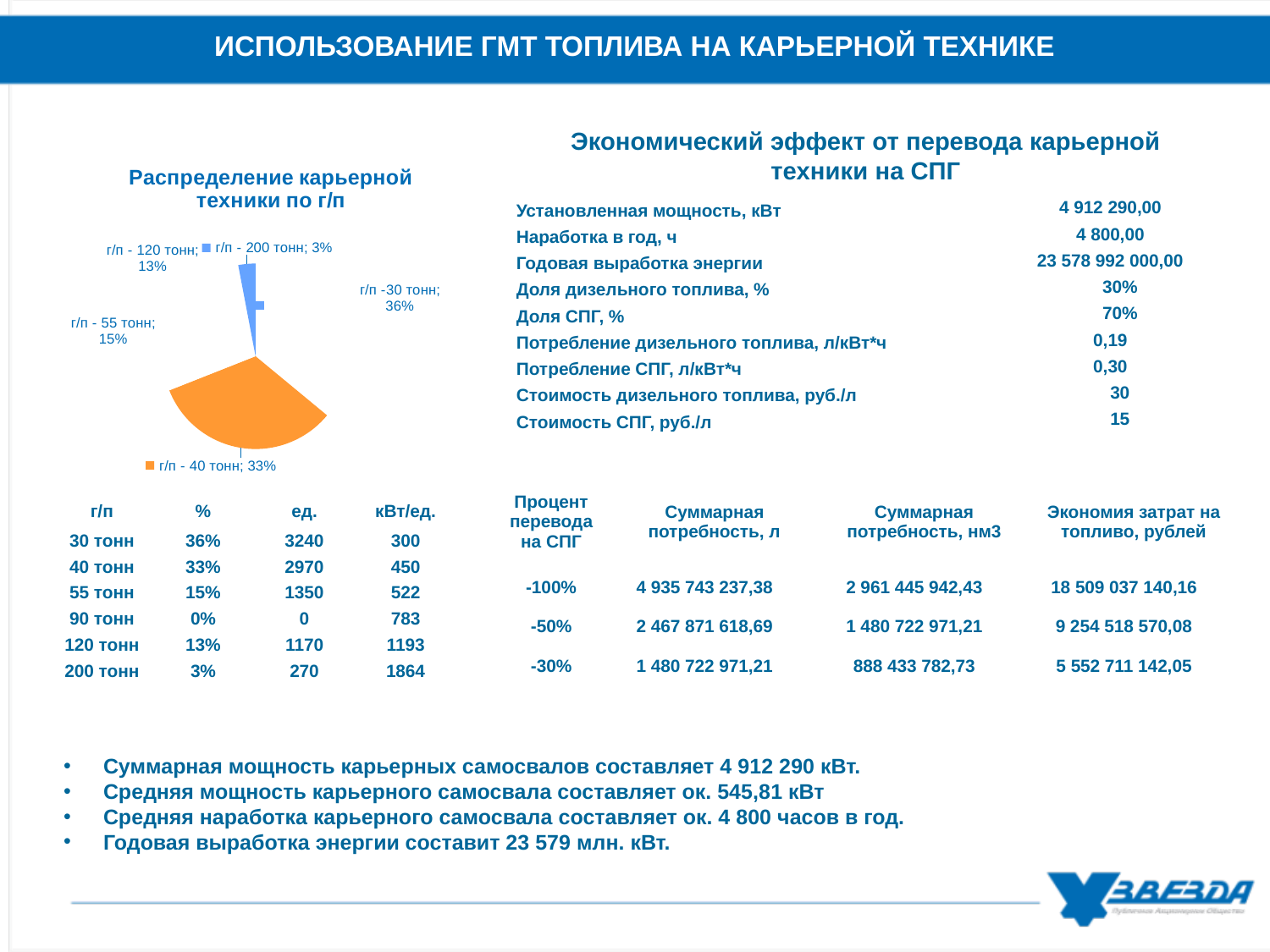
In the pie chart 'Распределение карьерной техники по г/п', what share is labelled for г/п -30 тонн? 36% What kind of chart is 'Распределение карьерной техники по г/п'? pie chart In the pie chart 'Распределение карьерной техники по г/п', what is the difference in percentage points between the shares of г/п -30 тонн and г/п - 40 тонн? 3 In the pie chart 'Распределение карьерной техники по г/п', which has the larger share: г/п - 55 тонн or г/п - 120 тонн? г/п - 55 тонн In the pie chart 'Распределение карьерной техники по г/п', what share is labelled for г/п - 40 тонн? 33% In the pie chart 'Распределение карьерной техники по г/п', what share is labelled for г/п - 55 тонн? 15% In the pie chart 'Распределение карьерной техники по г/п', which labelled category has the smallest share? г/п - 200 тонн In the pie chart 'Распределение карьерной техники по г/п', what share is labelled for г/п - 120 тонн? 13% In the pie chart 'Распределение карьерной техники по г/п', which category has the largest share? г/п -30 тонн What is the title of the pie chart on the left of the slide? Распределение карьерной техники по г/п In the pie chart 'Распределение карьерной техники по г/п', what share is labelled for г/п - 200 тонн? 3% How many labelled slices does the pie chart 'Распределение карьерной техники по г/п' show? 5